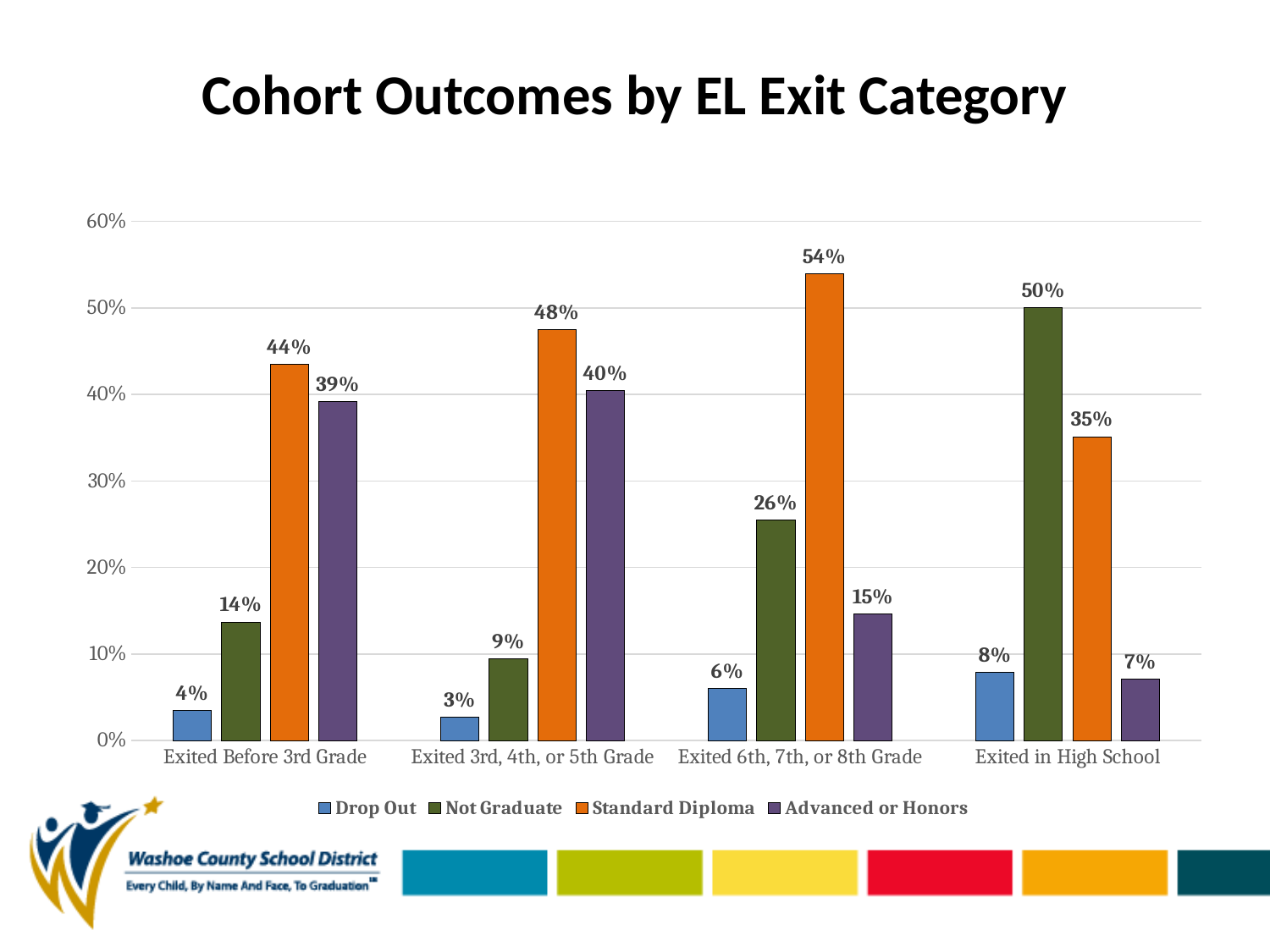
Which is larger for Exited Before 3rd Grade: Standard Diploma or Advanced or Honors? Standard Diploma How many series does the legend list? 4 How many exit categories are shown on the x axis? 4 What is the Standard Diploma value for Exited 6th, 7th, or 8th Grade? 54% What is the difference between the Standard Diploma values for Exited 6th, 7th, or 8th Grade and Exited in High School? 19% Which exit category has the lowest Drop Out value? Exited 3rd, 4th, or 5th Grade What is the Drop Out value for Exited 3rd, 4th, or 5th Grade? 3% Which exit category has the highest Advanced or Honors value? Exited 3rd, 4th, or 5th Grade What is the Not Graduate value for Exited in High School? 50% What is the Advanced or Honors value for Exited Before 3rd Grade? 39% What kind of chart is shown on the slide? Bar chart